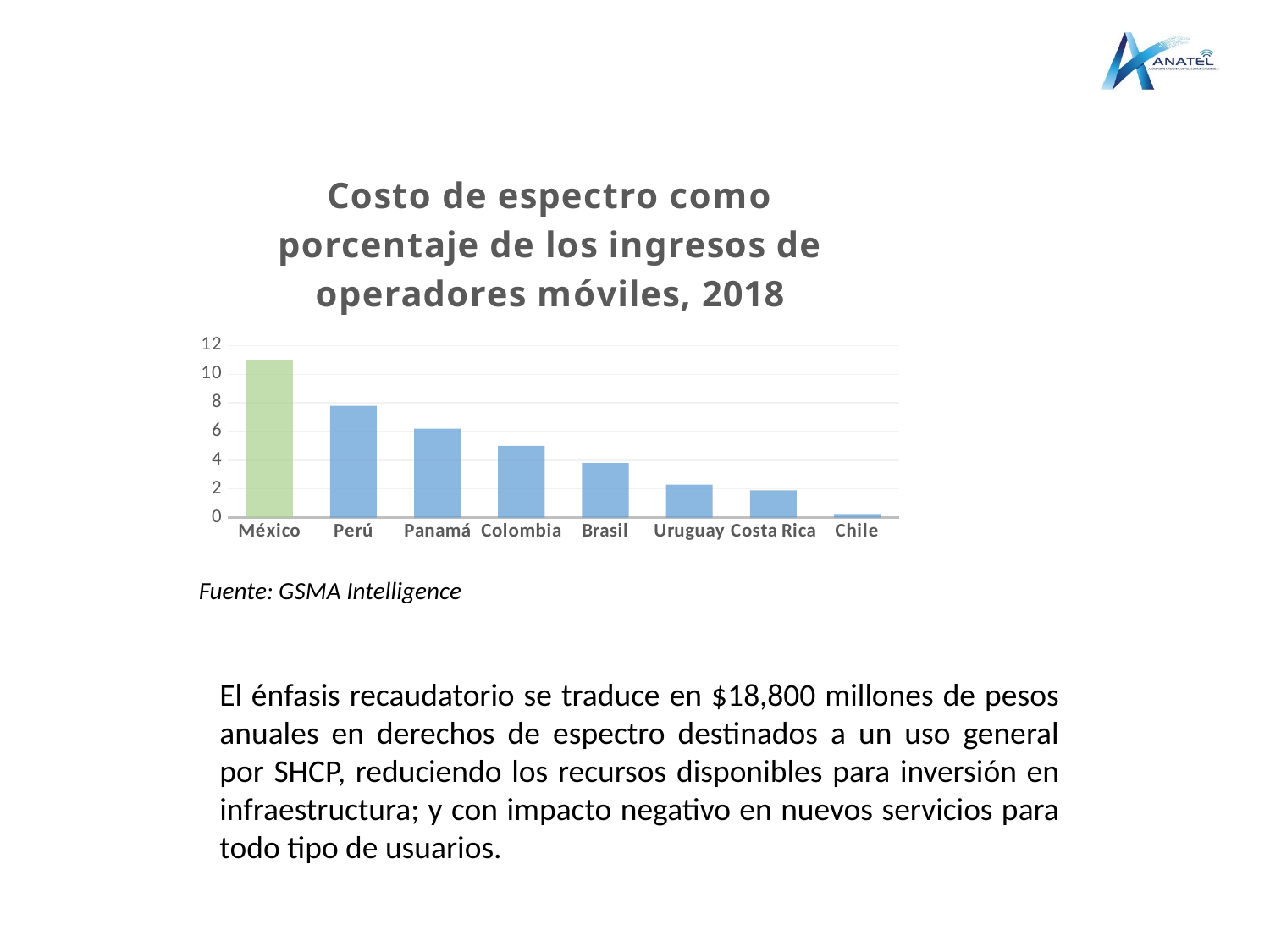
Is the value for Chile greater or less than 2? less Which country's bar is shown in a different colour (green) from the others? México Which country has the lowest spectrum cost as a percentage of mobile operator revenues? Chile Which country has the highest spectrum cost as a percentage of mobile operator revenues? México What type of chart is shown on the slide? bar chart Which is larger, the value for Perú or the value for Brasil? Perú Is the value for Colombia greater or less than 4? greater Is the value for Panamá greater or less than 8? less Do the values rise or fall from left to right across the countries? fall How many countries are shown in the chart? 8